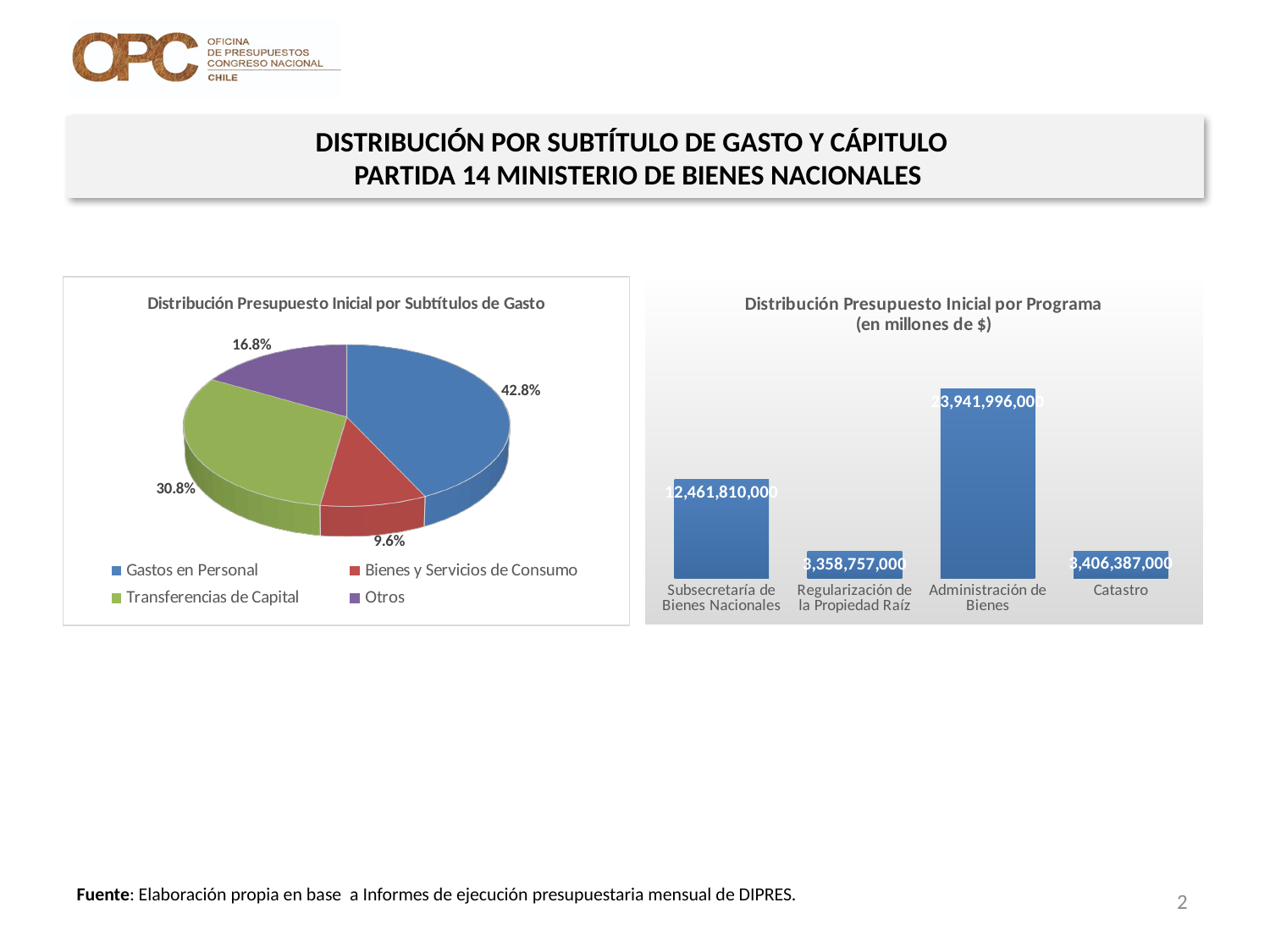
In the pie chart 'Distribución Presupuesto Inicial por Subtítulos de Gasto', how many categories does the legend list? 4 In the pie chart 'Distribución Presupuesto Inicial por Subtítulos de Gasto', what share does Transferencias de Capital have? 30.8% In the bar chart 'Distribución Presupuesto Inicial por Programa', which program has the highest value? Administración de Bienes In the pie chart 'Distribución Presupuesto Inicial por Subtítulos de Gasto', how many percentage points larger is Gastos en Personal than Transferencias de Capital? 12.0 percentage points What type of chart is 'Distribución Presupuesto Inicial por Programa'? Bar chart In the bar chart 'Distribución Presupuesto Inicial por Programa', what is the value for Administración de Bienes? 23,941,996,000 In the bar chart 'Distribución Presupuesto Inicial por Programa', which program has the lowest value? Regularización de la Propiedad Raíz In the pie chart 'Distribución Presupuesto Inicial por Subtítulos de Gasto', what share does Gastos en Personal have? 42.8% In the bar chart 'Distribución Presupuesto Inicial por Programa', what is the difference between Administración de Bienes and Subsecretaría de Bienes Nacionales? 11,480,186,000 In the bar chart 'Distribución Presupuesto Inicial por Programa', what is the value for Subsecretaría de Bienes Nacionales? 12,461,810,000 In the pie chart 'Distribución Presupuesto Inicial por Subtítulos de Gasto', which category has the smallest share? Bienes y Servicios de Consumo In the pie chart 'Distribución Presupuesto Inicial por Subtítulos de Gasto', which colour represents Otros? Purple